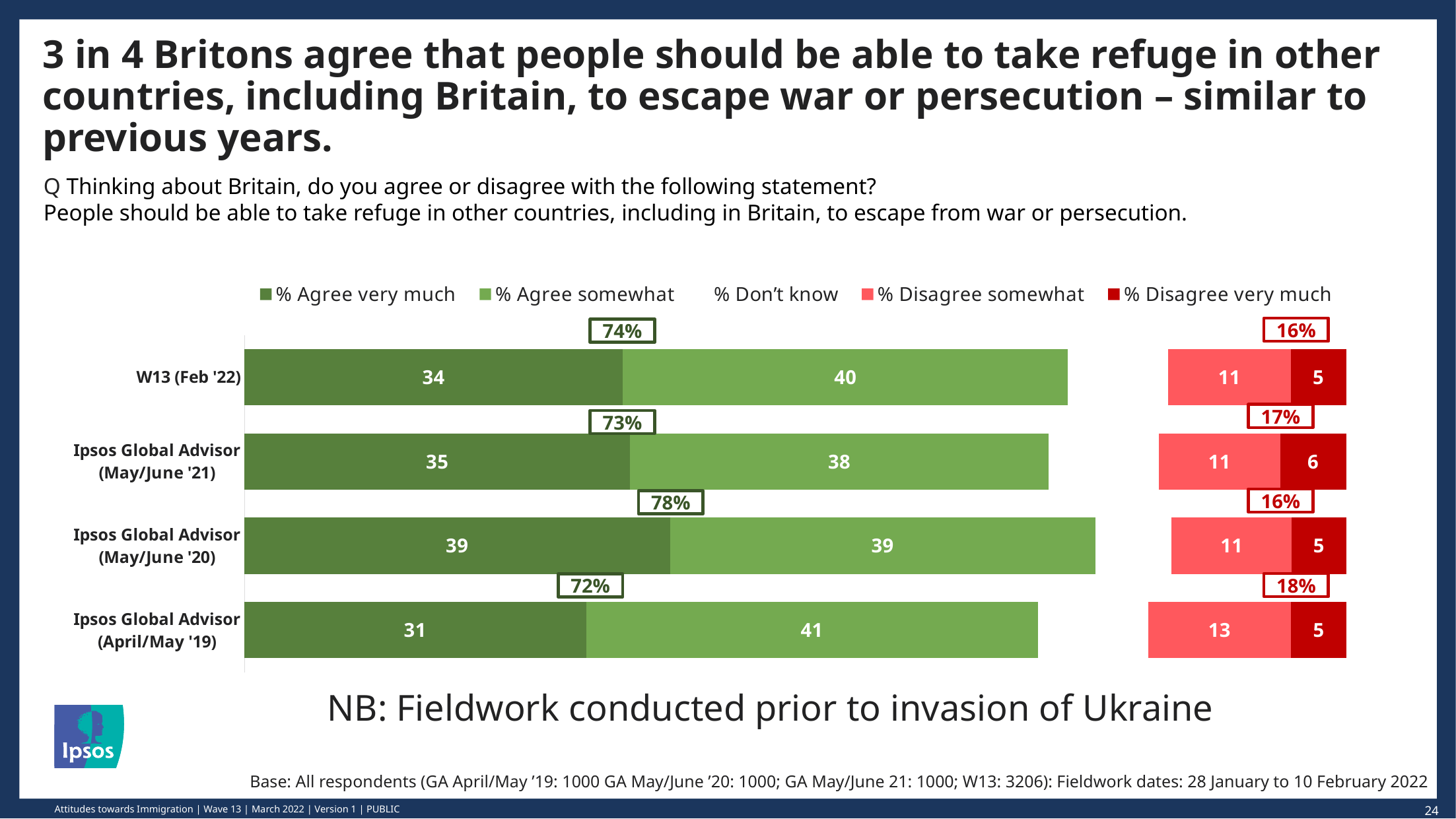
What is the % Disagree somewhat value for Ipsos Global Advisor (May/June '21)? 11 What is the difference between the % Agree somewhat values for W13 (Feb '22) and Ipsos Global Advisor (May/June '21)? 2 How many series does the chart legend list? 5 Which survey wave has the lowest % Agree very much value? Ipsos Global Advisor (April/May '19) Which is larger: the % Disagree very much value for Ipsos Global Advisor (May/June '21) or for W13 (Feb '22)? Ipsos Global Advisor (May/June '21) What type of chart is shown on the slide? Stacked bar chart Which survey wave has the highest % Agree very much value? Ipsos Global Advisor (May/June '20) How many survey waves (categories) are plotted in the chart? 4 What is the % Agree very much value for W13 (Feb '22)? 34 What is the total disagree percentage shown for Ipsos Global Advisor (April/May '19)? 18% What is the % Agree somewhat value for Ipsos Global Advisor (April/May '19)? 41 What is the total agree percentage shown for Ipsos Global Advisor (May/June '20)? 78%